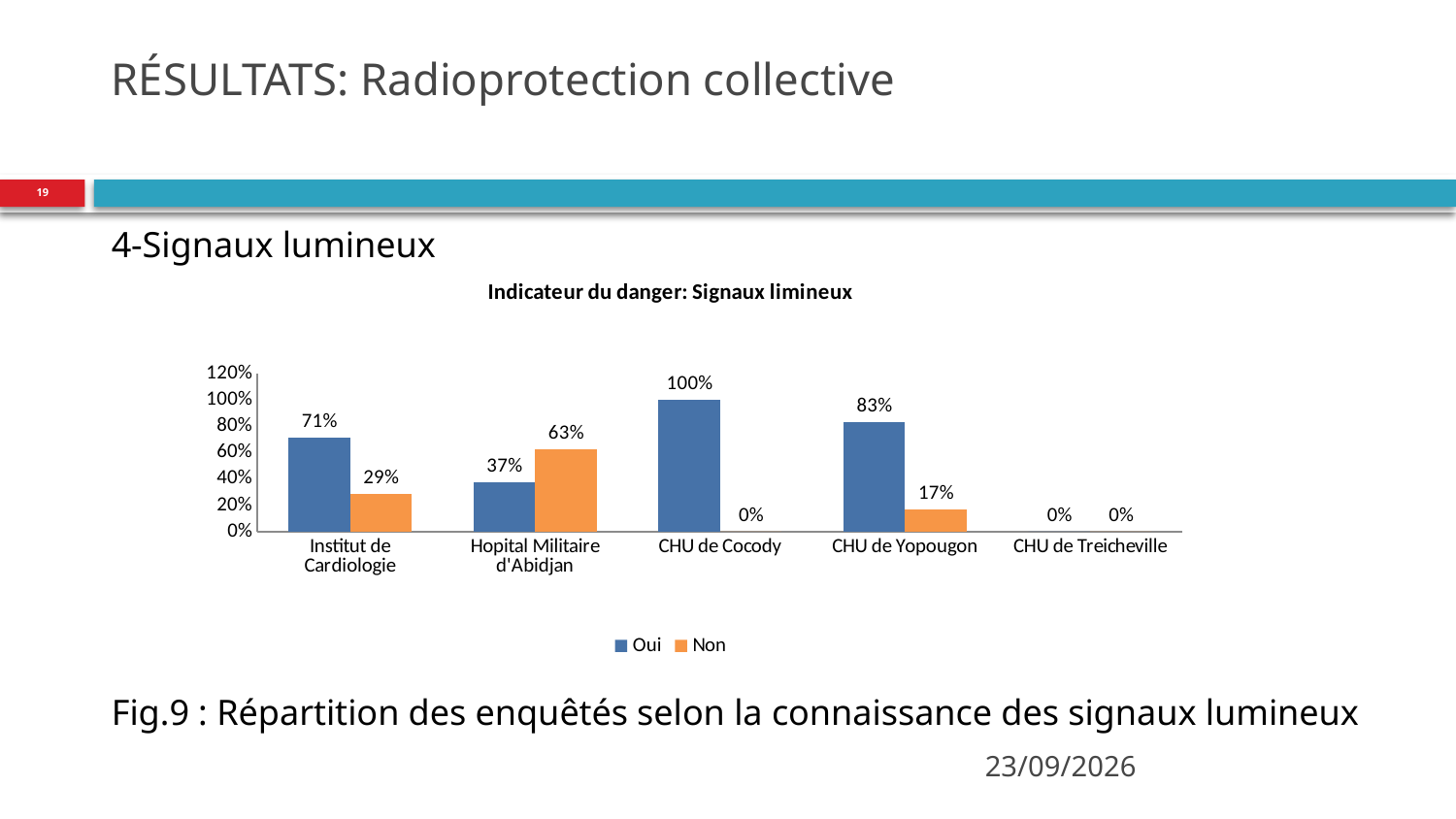
What is the title of the chart? Indicateur du danger: Signaux limineux What is the 'Oui' value for CHU de Yopougon? 83% What is the 'Oui' value for Institut de Cardiologie? 71% What is the 'Non' value for Hopital Militaire d'Abidjan? 63% How many series does the legend list? 2 What is the difference between the 'Oui' and 'Non' values for Institut de Cardiologie? 42% What is the 'Non' value for CHU de Yopougon? 17% What kind of chart is shown on the slide? Bar chart Which category has the highest 'Oui' value? CHU de Cocody Which is larger for Hopital Militaire d'Abidjan, the 'Oui' value or the 'Non' value? Non How many categories are shown on the x axis? 5 Which category has the highest 'Non' value? Hopital Militaire d'Abidjan